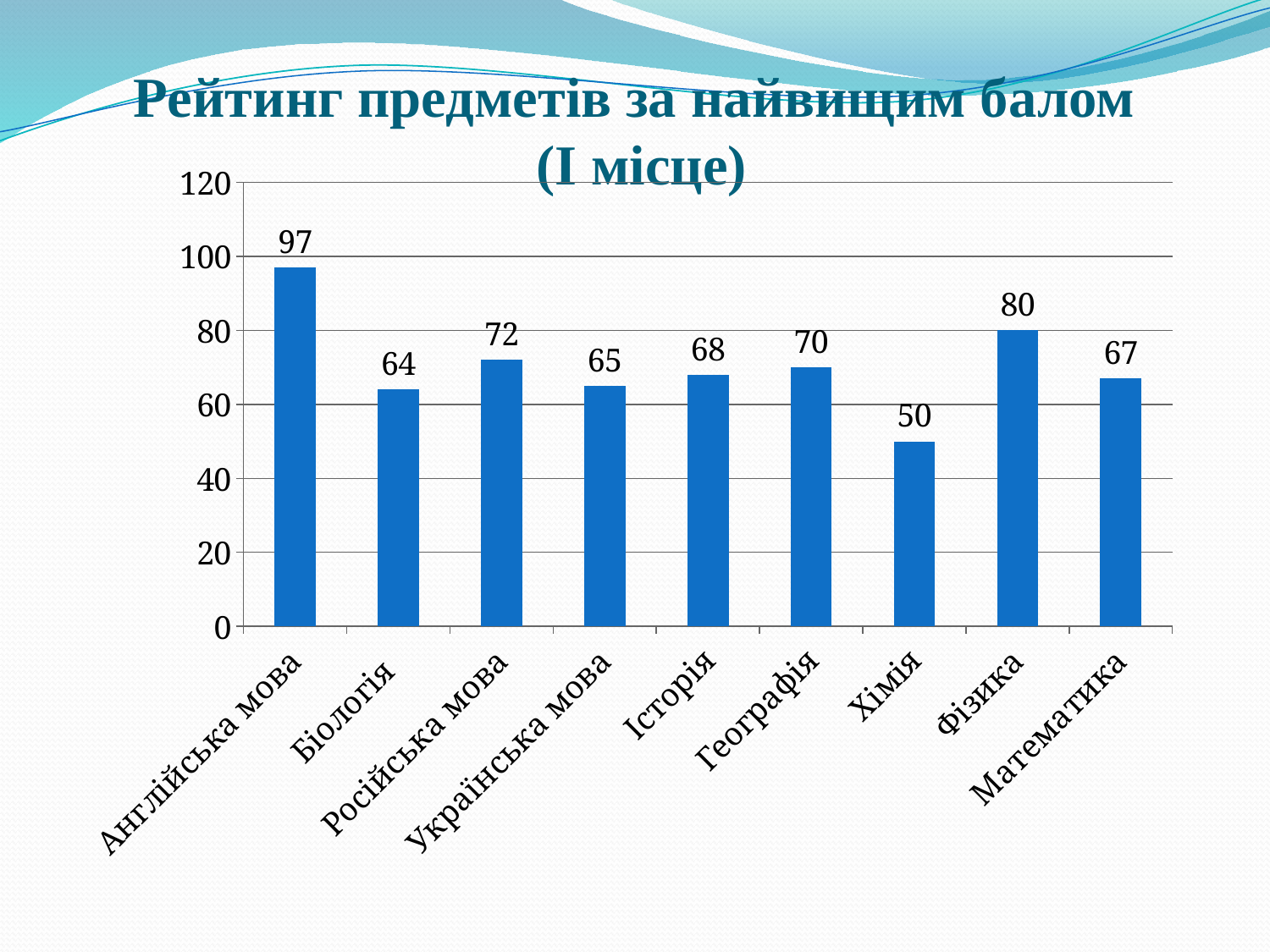
What is the value for Хімія? 50 What kind of chart is shown on the slide? bar chart What is the value for Географія? 70 How many subjects are shown on the chart? 9 What is the difference between the values for Російська мова and Українська мова? 7 What is the value for Англійська мова? 97 Which subject has the lowest value? Хімія Is the value for Історія greater or less than 60? greater What is the difference between the values for Англійська мова and Фізика? 17 Which subject has the highest value? Англійська мова What is the value for Фізика? 80 Which is larger, the value for Біологія or the value for Математика? Математика